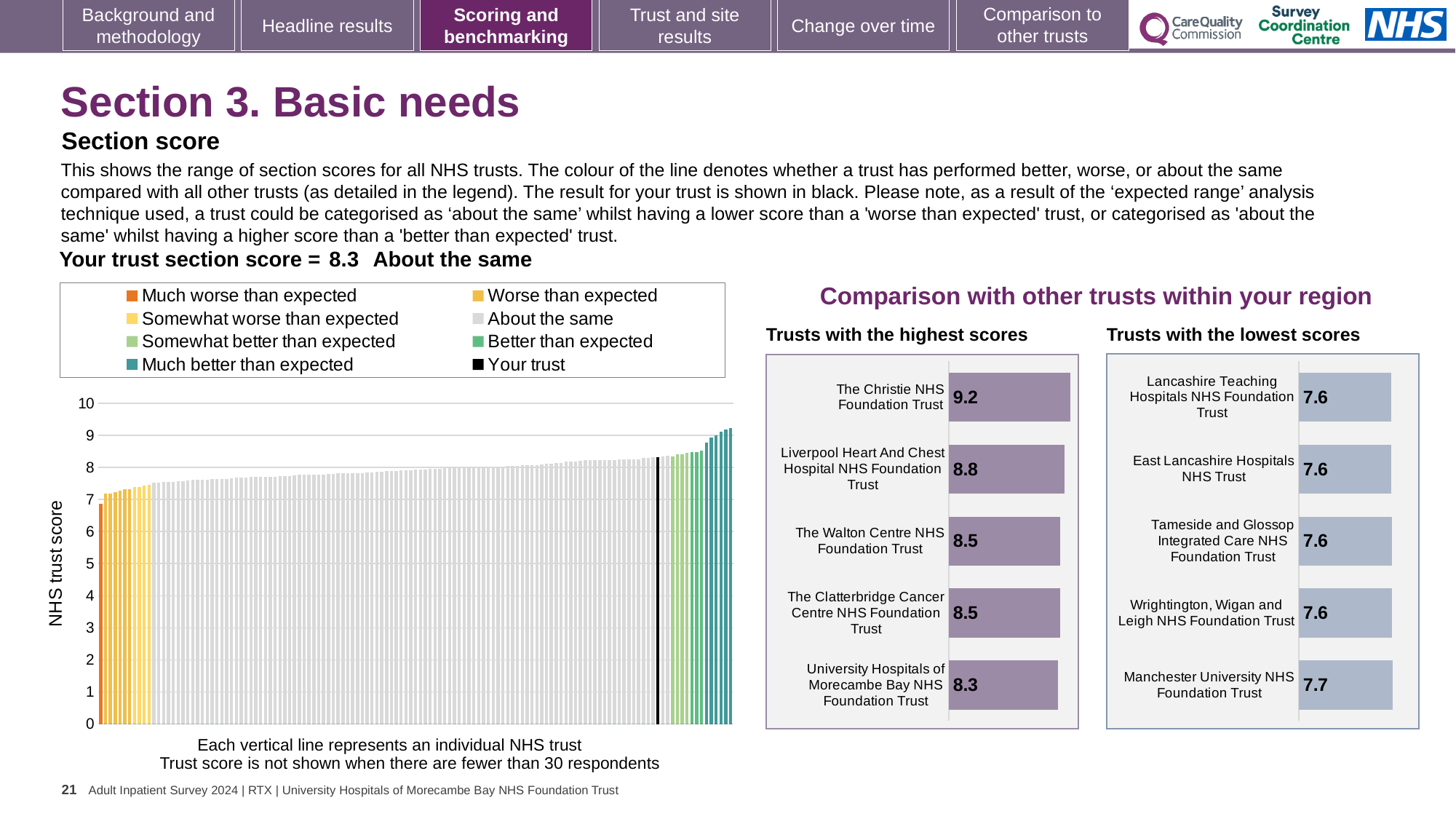
On the 'Trusts with the lowest scores' chart, what is the score for Manchester University NHS Foundation Trust? 7.7 Which is larger: the score for Liverpool Heart And Chest Hospital NHS Foundation Trust on the highest scores chart, or the score for Lancashire Teaching Hospitals NHS Foundation Trust on the lowest scores chart? Liverpool Heart And Chest Hospital NHS Foundation Trust On the 'Trusts with the lowest scores' chart, which trust has the highest score? Manchester University NHS Foundation Trust On the large 'NHS trust score' chart, is the value of the tallest bar greater or less than 9? greater On the 'Trusts with the highest scores' chart, what is the difference between the scores of The Christie NHS Foundation Trust and University Hospitals of Morecambe Bay NHS Foundation Trust? 0.9 On the 'Trusts with the highest scores' chart, what is the score for The Christie NHS Foundation Trust? 9.2 On the 'Trusts with the lowest scores' chart, what is the difference between the scores of Manchester University NHS Foundation Trust and East Lancashire Hospitals NHS Trust? 0.1 On the large 'NHS trust score' chart, do the values rise or fall from left to right? Rise How many entries does the legend of the large 'NHS trust score' chart list? 8 What kind of chart is the large 'NHS trust score' chart on the left of the slide? Bar chart On the 'Trusts with the highest scores' chart, how many trusts are shown? 5 On the 'Trusts with the highest scores' chart, which trust has the lowest score? University Hospitals of Morecambe Bay NHS Foundation Trust